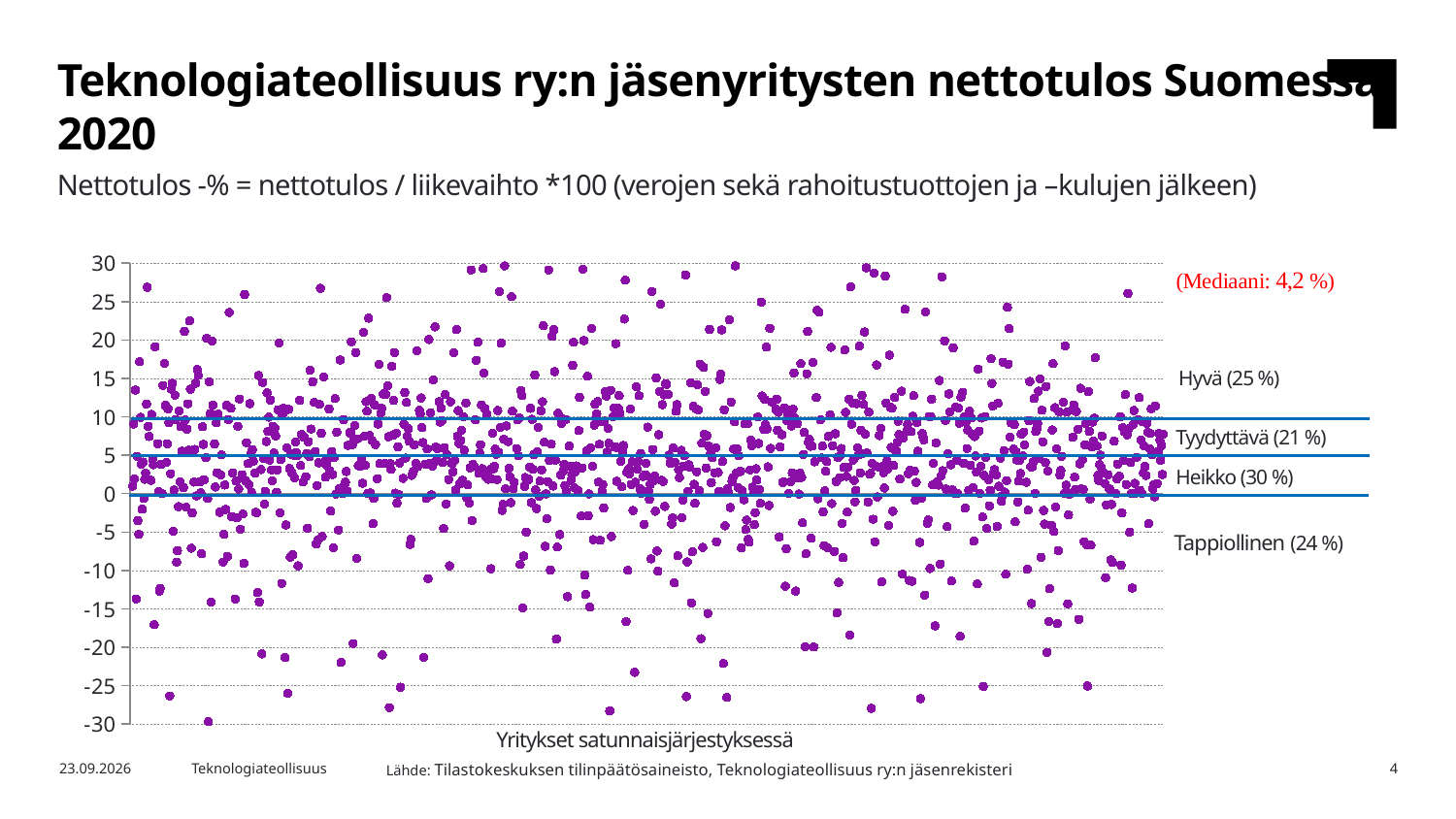
What kind of chart is shown on the slide? Scatter chart By how many percentage points does the share of 'Heikko' companies exceed the share of 'Tyydyttävä' companies? 9 percentage points Which of the four labelled categories (Hyvä, Tyydyttävä, Heikko, Tappiollinen) has the smallest share of companies? Tyydyttävä What is the highest value shown on the vertical axis of the chart? 30 What median net profit percentage is annotated on the chart? 4,2 % Which share is larger, 'Hyvä' or 'Tappiollinen'? Hyvä What share of companies is labelled as 'Hyvä' on the chart? 25 % What share of companies is labelled as 'Tappiollinen' on the chart? 24 % What share of companies is labelled as 'Heikko' on the chart? 30 % What is the label of the horizontal axis of the chart? Yritykset satunnaisjärjestyksessä What share of companies is labelled as 'Tyydyttävä' on the chart? 21 % Which of the four labelled categories (Hyvä, Tyydyttävä, Heikko, Tappiollinen) has the largest share of companies? Heikko